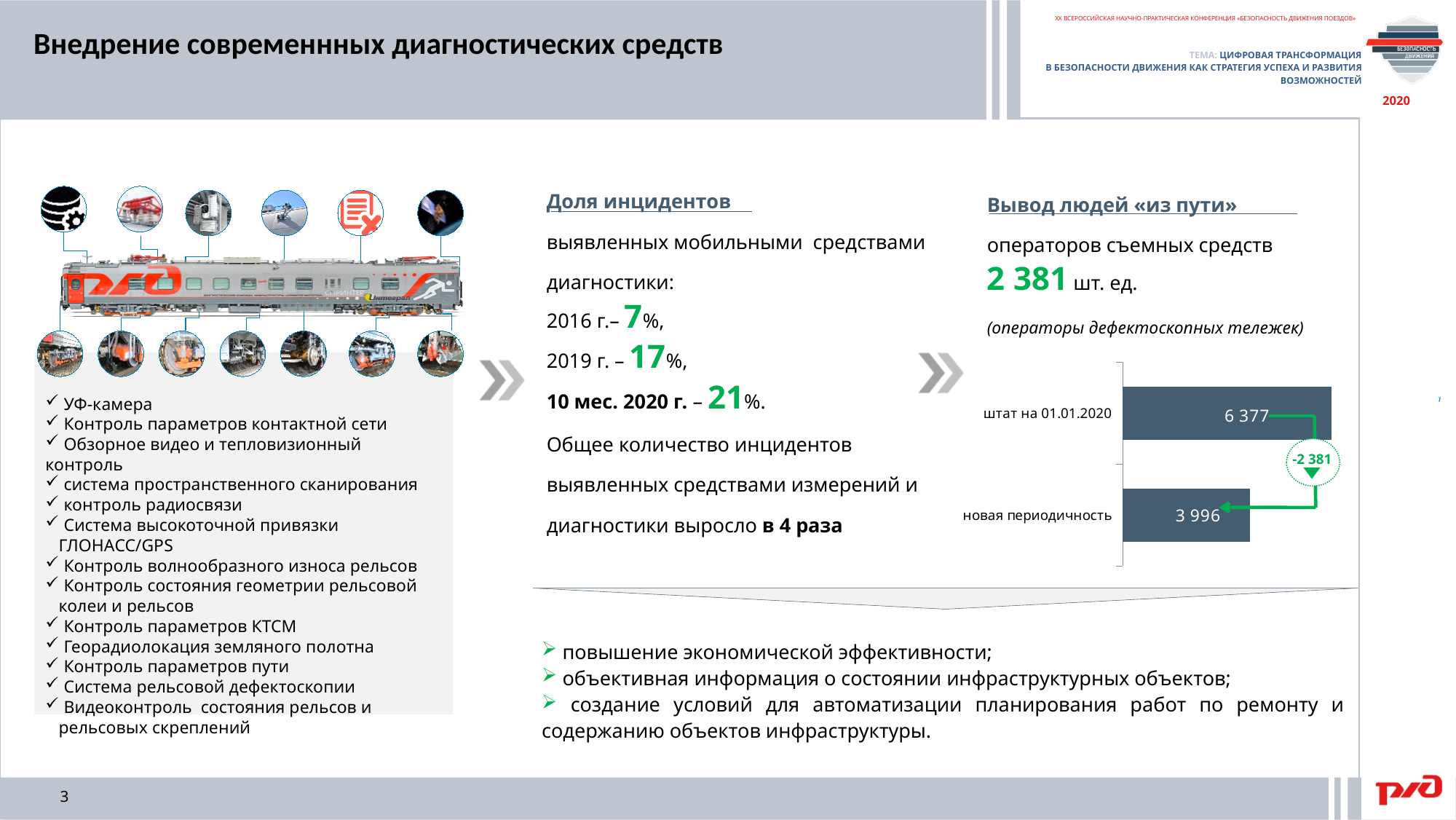
Which is larger: the value for «штат на 01.01.2020» or for «новая периодичность»? штат на 01.01.2020 What is the difference between the «штат на 01.01.2020» bar and the «новая периодичность» bar? 2 381 Which bar in the chart is the highest? штат на 01.01.2020 What kind of chart is shown on the slide? bar chart What is the value of the bar labelled «новая периодичность»? 3 996 What is the value of the bar labelled «штат на 01.01.2020»? 6 377 Which bar in the chart is the lowest? новая периодичность How many bars does the chart contain? 2 Under which heading is the bar chart placed on the slide? Вывод людей «из пути» What change is annotated between the two bars in the chart? -2 381